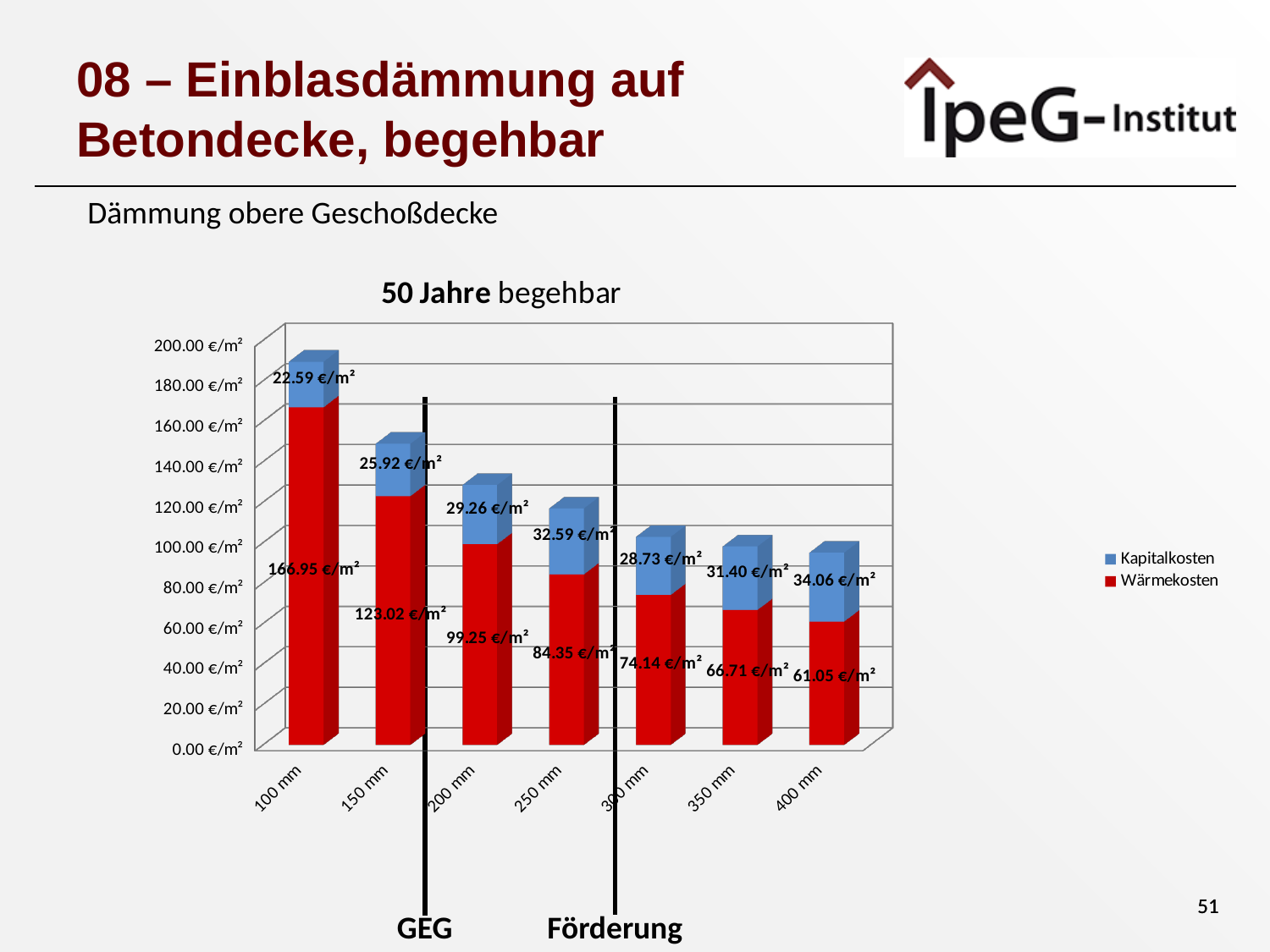
Which is larger, the Kapitalkosten value for 250 mm or for 300 mm? 250 mm Which category has the highest Wärmekosten value? 100 mm How many categories are shown on the x axis? 7 How many series does the legend list? 2 What is the Wärmekosten value for 250 mm? 84.35 €/m² What is the Wärmekosten value for 100 mm? 166.95 €/m² Do the Wärmekosten values rise or fall as the insulation thickness increases along the x axis? Fall What is the difference between the Wärmekosten values for 100 mm and 150 mm? 43.93 €/m² What is the Kapitalkosten value for 400 mm? 34.06 €/m² Which category has the lowest Kapitalkosten value? 100 mm What is the total of the stacked bar for 200 mm? 128.51 €/m² What kind of chart is shown? Stacked bar chart